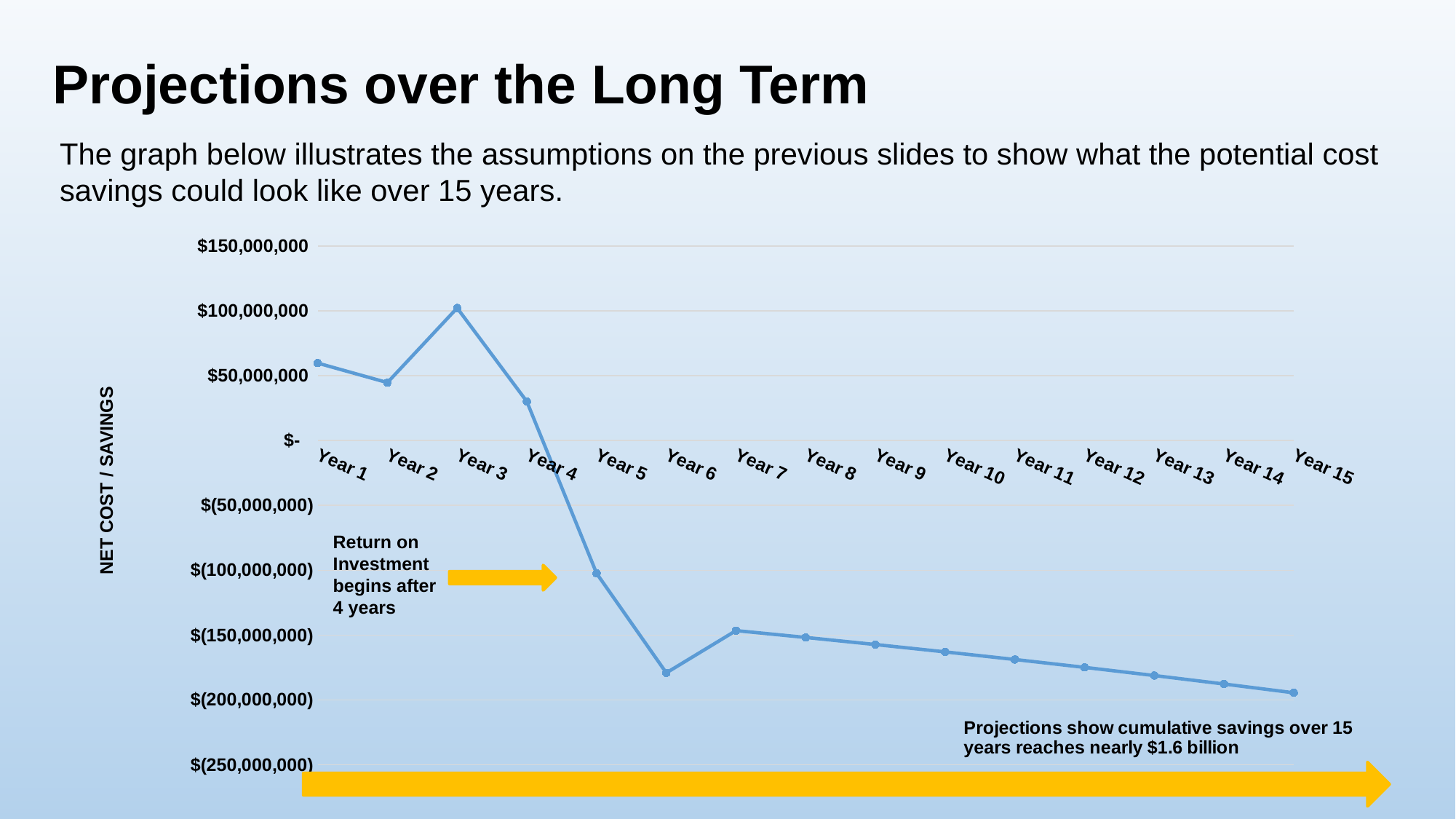
Is the value for Year 1 greater or less than $50,000,000? greater Which year has the lowest value on the chart? Year 15 Is the value for Year 4 greater or less than $50,000,000? less How many years (data points) are plotted on the x axis? 15 What is the title of the vertical axis? NET COST / SAVINGS Is the value for Year 6 greater or less than $(150,000,000)? less What kind of chart is shown on the slide? Line chart Which is larger, the value for Year 1 or the value for Year 2? Year 1 Which is larger, the value for Year 6 or the value for Year 7? Year 7 From Year 7 to Year 15, do the values rise or fall? Fall Which year has the highest value on the chart? Year 3